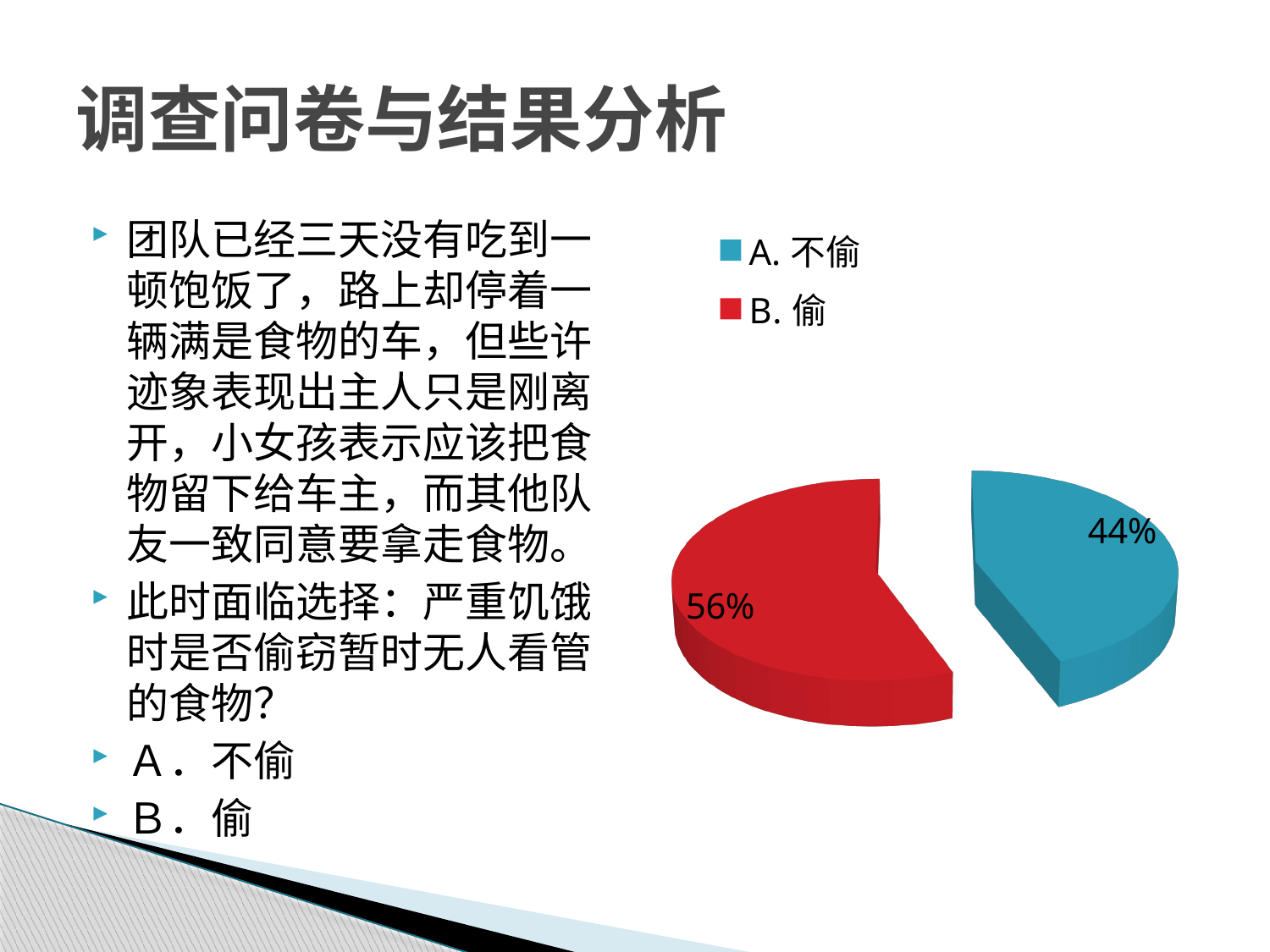
How many slices does the pie chart have? 2 How many entries does the legend list? 2 Which slice of the pie is the largest? B. 偷 Which slice of the pie is the smallest? A. 不偷 What is the difference in percentage points between "B. 偷" and "A. 不偷"? 12% What kind of chart is shown on the slide? Pie chart What colour is the slice for "B. 偷"? Red What colour is the slice for "A. 不偷"? Blue What is the total of the two slices shown in the pie chart? 100% What share of the pie does "A. 不偷" represent? 44% What share of the pie does "B. 偷" represent? 56% Which is larger, the share for "A. 不偷" or the share for "B. 偷"? B. 偷